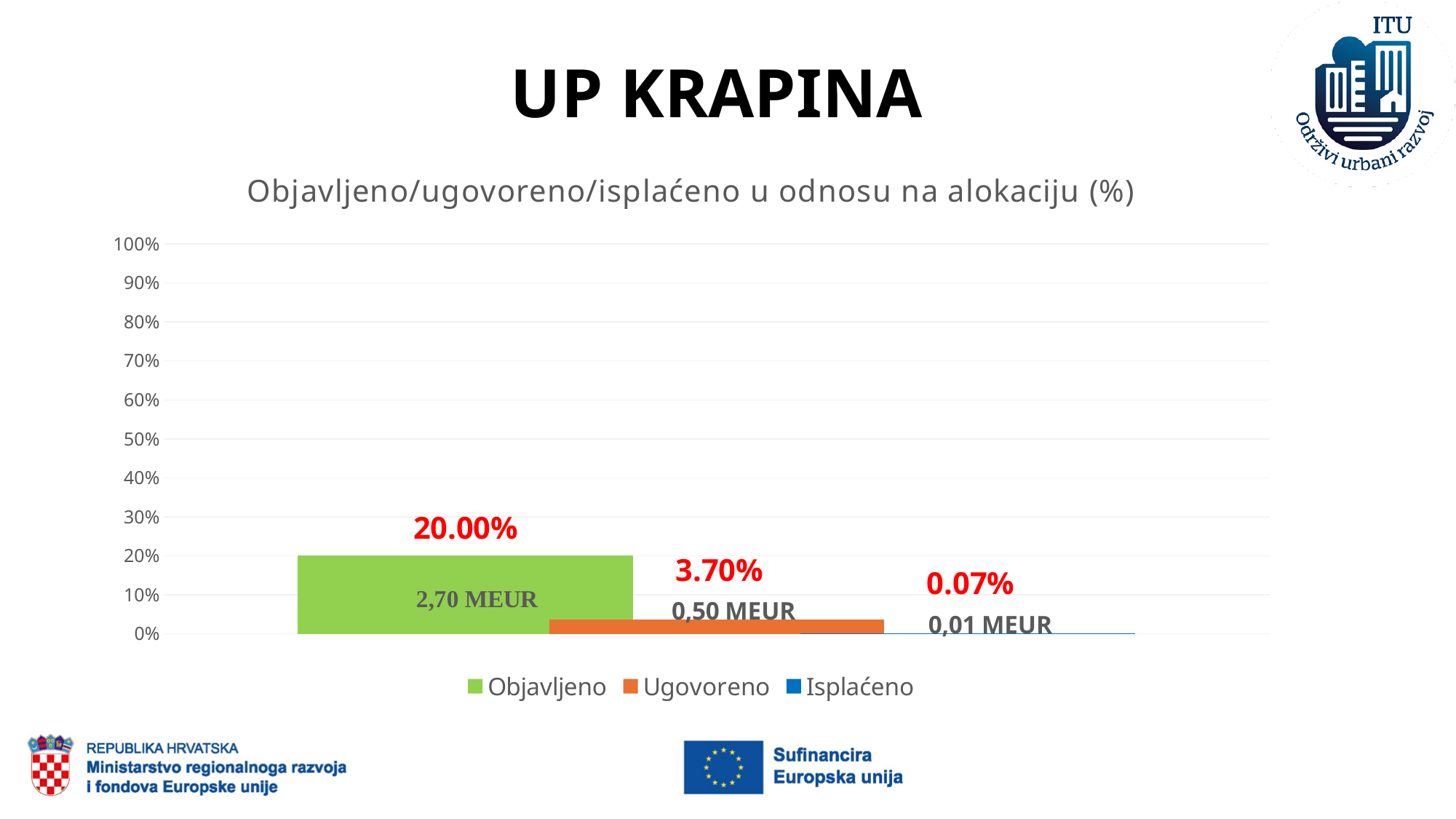
Is the value for Objavljeno greater or less than 30%? less What is the value for Ugovoreno? 3.70% What kind of chart is shown? bar chart What is the value for Objavljeno? 20.00% What is the value for Isplaćeno? 0.07% Which series has the lowest value? Isplaćeno What amount in MEUR is shown for Ugovoreno? 0,50 MEUR Which series has the highest value? Objavljeno What amount in MEUR is shown for Objavljeno? 2,70 MEUR How many series does the legend list? 3 What is the difference between the Objavljeno and Ugovoreno percentages? 16.30% Which is larger, Ugovoreno or Isplaćeno? Ugovoreno